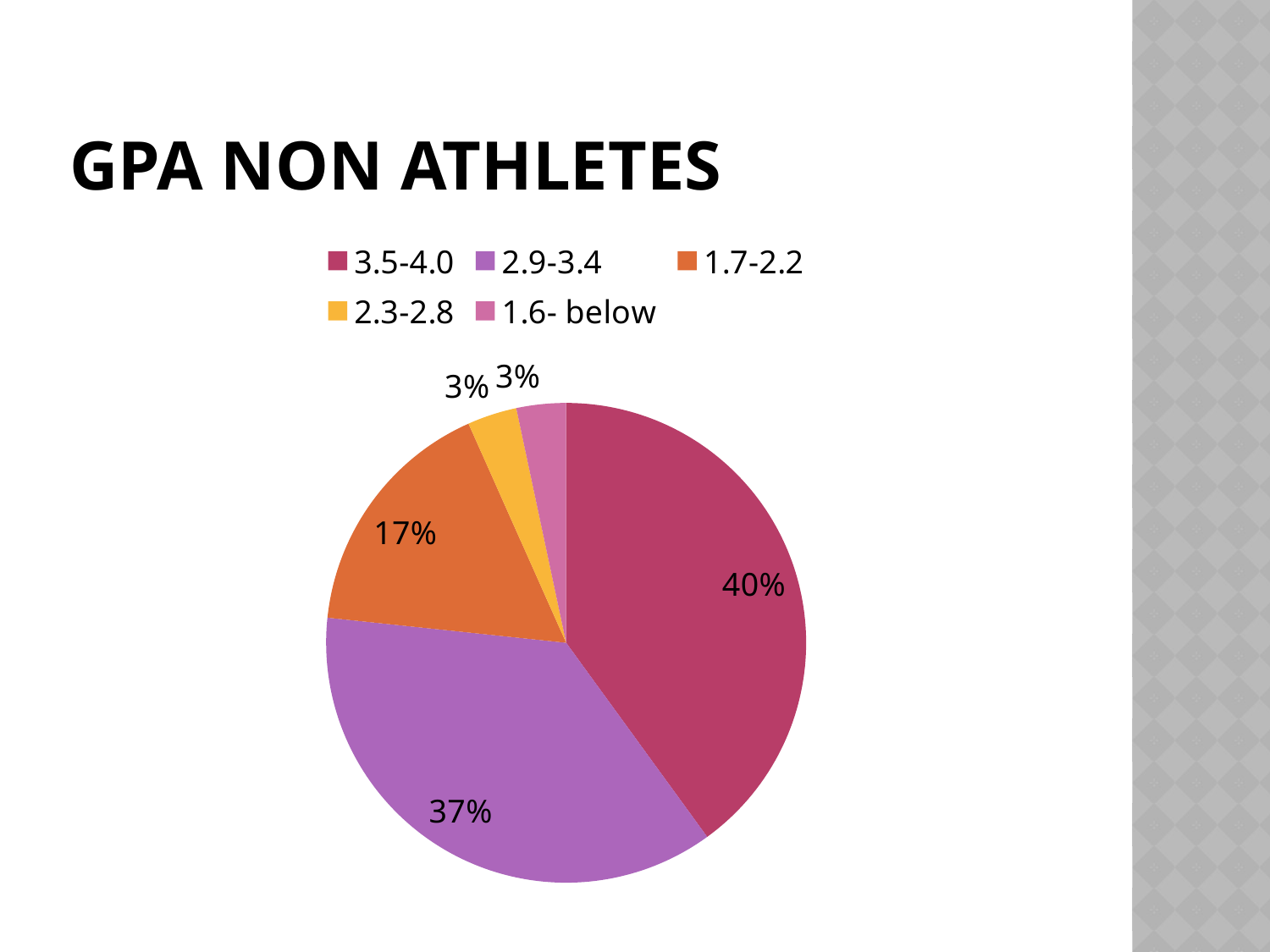
Which GPA range has the largest slice of the pie? 3.5-4.0 Which is larger, the 1.7-2.2 slice or the 2.3-2.8 slice? 1.7-2.2 What kind of chart is shown on the slide? Pie chart What is the title of the slide containing the pie chart? GPA NON ATHLETES What share of the pie does the 1.7-2.2 GPA range have? 17% What is the difference in percentage points between the 2.9-3.4 slice and the 1.7-2.2 slice? 20 What share of the pie does the 1.6- below GPA range have? 3% What share of the pie does the 2.9-3.4 GPA range have? 37% How many GPA ranges does the legend list? 5 What is the difference in percentage points between the 3.5-4.0 slice and the 2.9-3.4 slice? 3